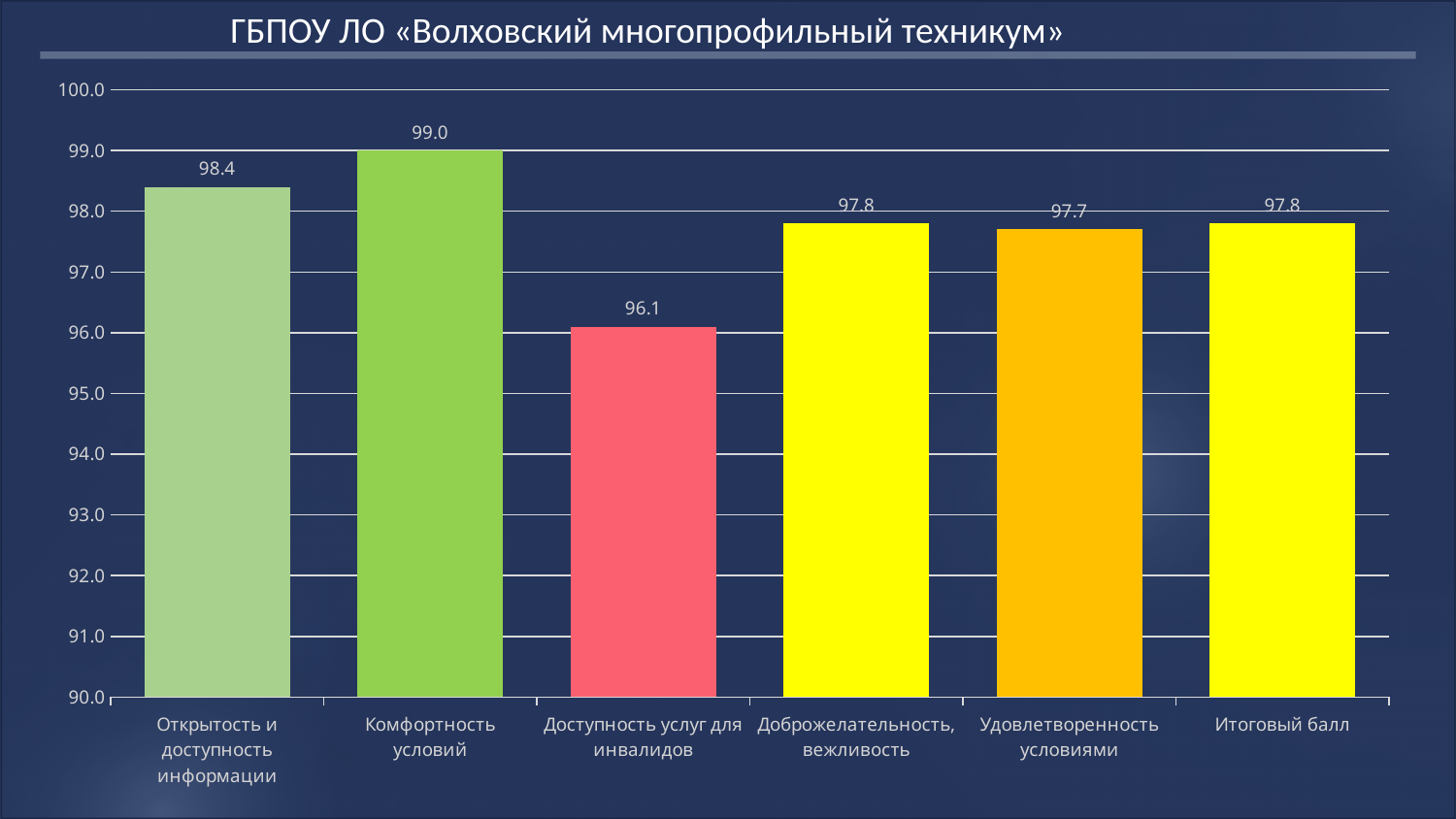
What is the difference between the values for «Комфортность условий» and «Доступность услуг для инвалидов»? 2.9 What is the value for «Открытость и доступность информации»? 98.4 What kind of chart is shown on the slide? bar chart Which category has the lowest value? Доступность услуг для инвалидов Is the value for «Доступность услуг для инвалидов» greater or less than 97.0? less What is the value for «Комфортность условий»? 99.0 Which is larger: the value for «Открытость и доступность информации» or the value for «Доброжелательность, вежливость»? Открытость и доступность информации What is the value for «Итоговый балл»? 97.8 Which category has the highest value? Комфортность условий What is the difference between the values for «Открытость и доступность информации» and «Удовлетворенность условиями»? 0.7 How many categories are shown on the chart? 6 What is the value for «Доступность услуг для инвалидов»? 96.1